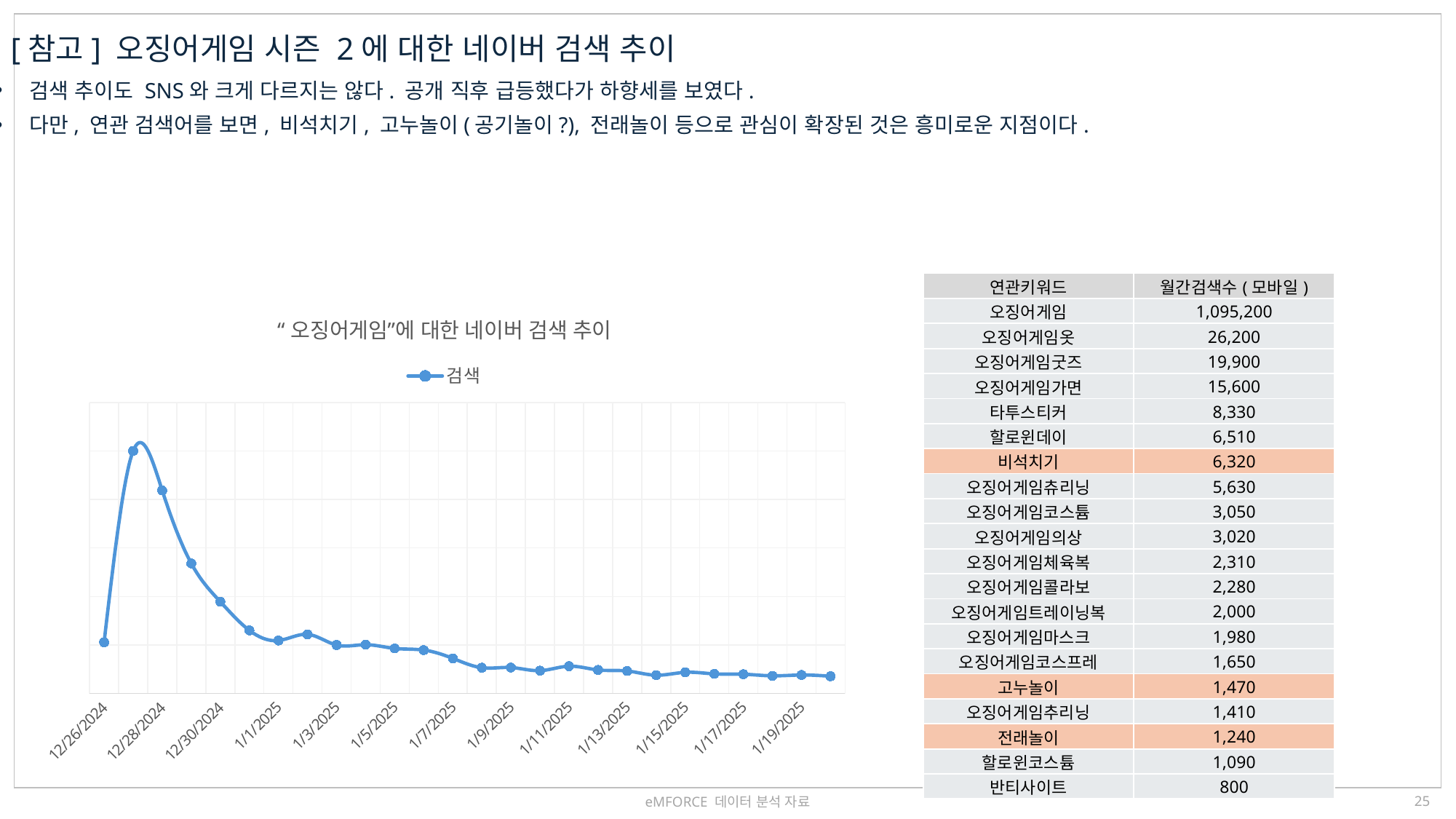
Do the values rise or fall along the x axis from 12/28/2024 to 1/19/2025? fall What is the first date label on the x axis of the chart? 12/26/2024 How many series does the chart's legend list? 1 Which has the larger value, 12/28/2024 or 12/30/2024? 12/28/2024 What is the title of the chart? "오징어게임"에 대한 네이버 검색 추이 What kind of chart is shown on the slide? line chart Which has the larger value, 12/30/2024 or 1/3/2025? 12/30/2024 Which has the larger value, 12/26/2024 or 12/28/2024? 12/28/2024 What is the name of the series shown in the chart's legend? 검색 How many date labels are shown on the x axis of the chart? 13 What is the last date label on the x axis of the chart? 1/19/2025